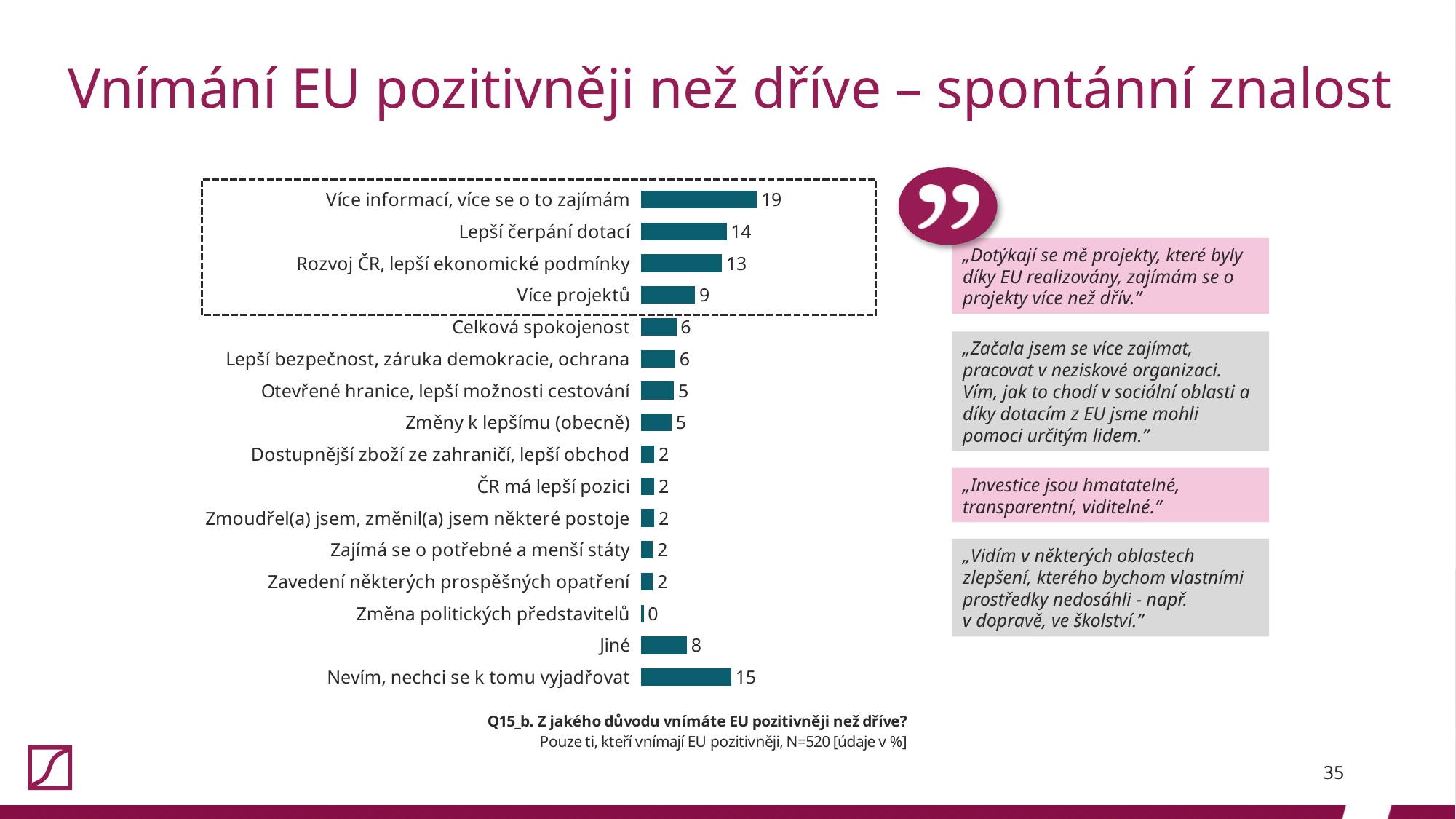
What kind of chart is shown on the slide? Bar chart What is the value for "Jiné"? 8 Which category has the highest value? Více informací, více se o to zajímám What is the value for "Nevím, nechci se k tomu vyjadřovat"? 15 What is the difference between the values for "Více informací, více se o to zajímám" and "Lepší čerpání dotací"? 5 What is the value for "Lepší čerpání dotací"? 14 Which category has the lowest value? Změna politických představitelů What is the sample size (N) stated below the chart? N=520 What is the value for "Více informací, více se o to zajímám"? 19 What is the difference between the values for "Nevím, nechci se k tomu vyjadřovat" and "Více projektů"? 6 How many categories are shown in the chart? 16 Which is larger, the value for "Rozvoj ČR, lepší ekonomické podmínky" or the value for "Jiné"? Rozvoj ČR, lepší ekonomické podmínky